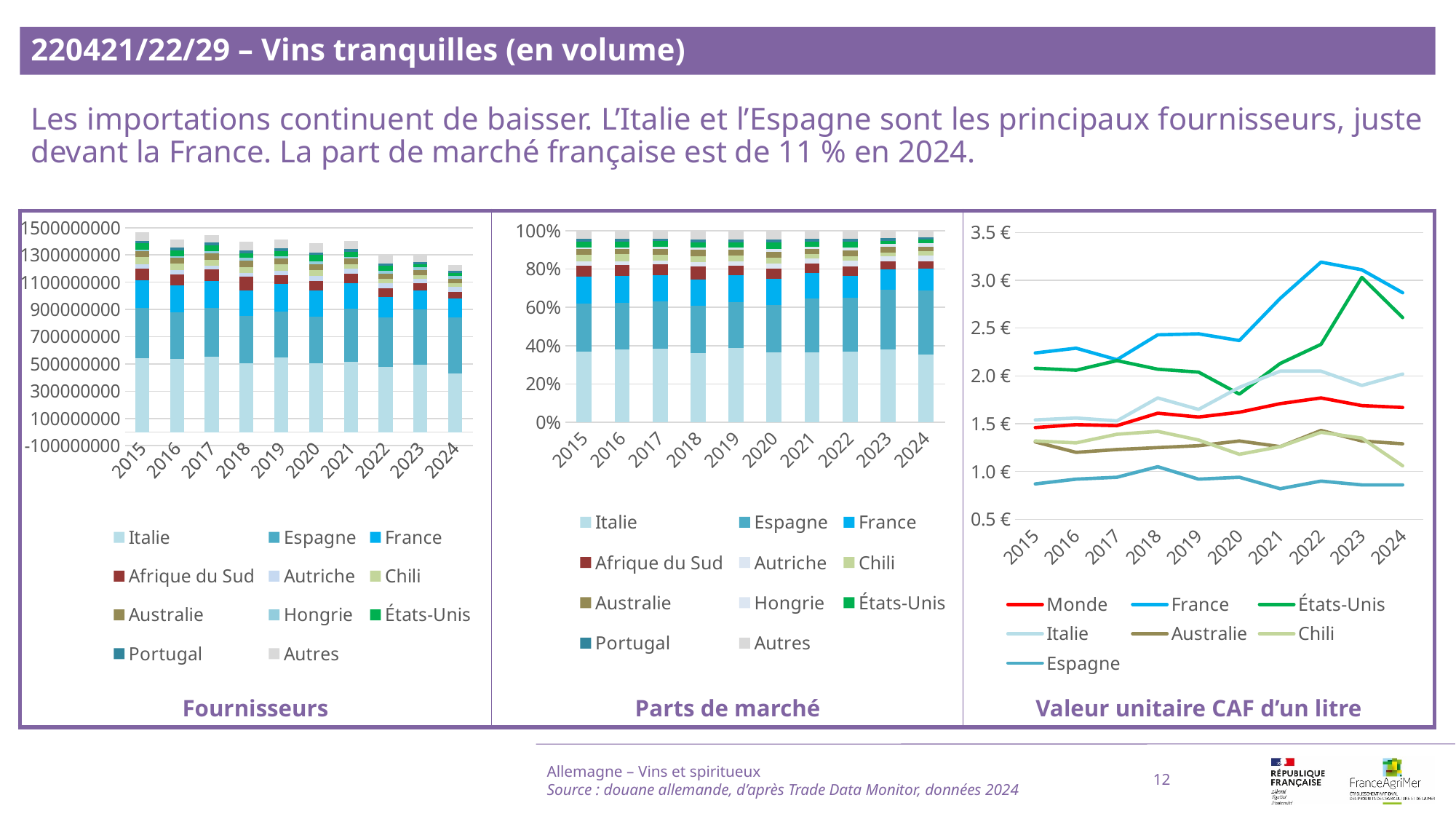
In the 'Valeur unitaire CAF d'un litre' chart, is the value for Espagne in 2015 greater or less than 1.0 €? less In the 'Fournisseurs' chart, how many years are shown on the x axis? 10 In the 'Valeur unitaire CAF d'un litre' chart, is the value for France in 2022 greater or less than 3.0 €? greater In the 'Valeur unitaire CAF d'un litre' chart, which series has the lowest value in 2024? Espagne In the 'Fournisseurs' chart, do the total stacked bars rise or fall from 2015 to 2024? fall In the 'Parts de marché' chart, which supplier has the largest share in 2015? Italie In the 'Valeur unitaire CAF d'un litre' chart, which series has the highest value in 2022? France What kind of chart is the 'Fournisseurs' chart on the left? bar chart How many series does the legend of the 'Fournisseurs' chart list? 11 In the 'Valeur unitaire CAF d'un litre' chart, which is higher in 2024: France or États-Unis? France What kind of chart is the 'Valeur unitaire CAF d'un litre' chart on the right? line chart How many series does the legend of the 'Valeur unitaire CAF d'un litre' chart list? 7